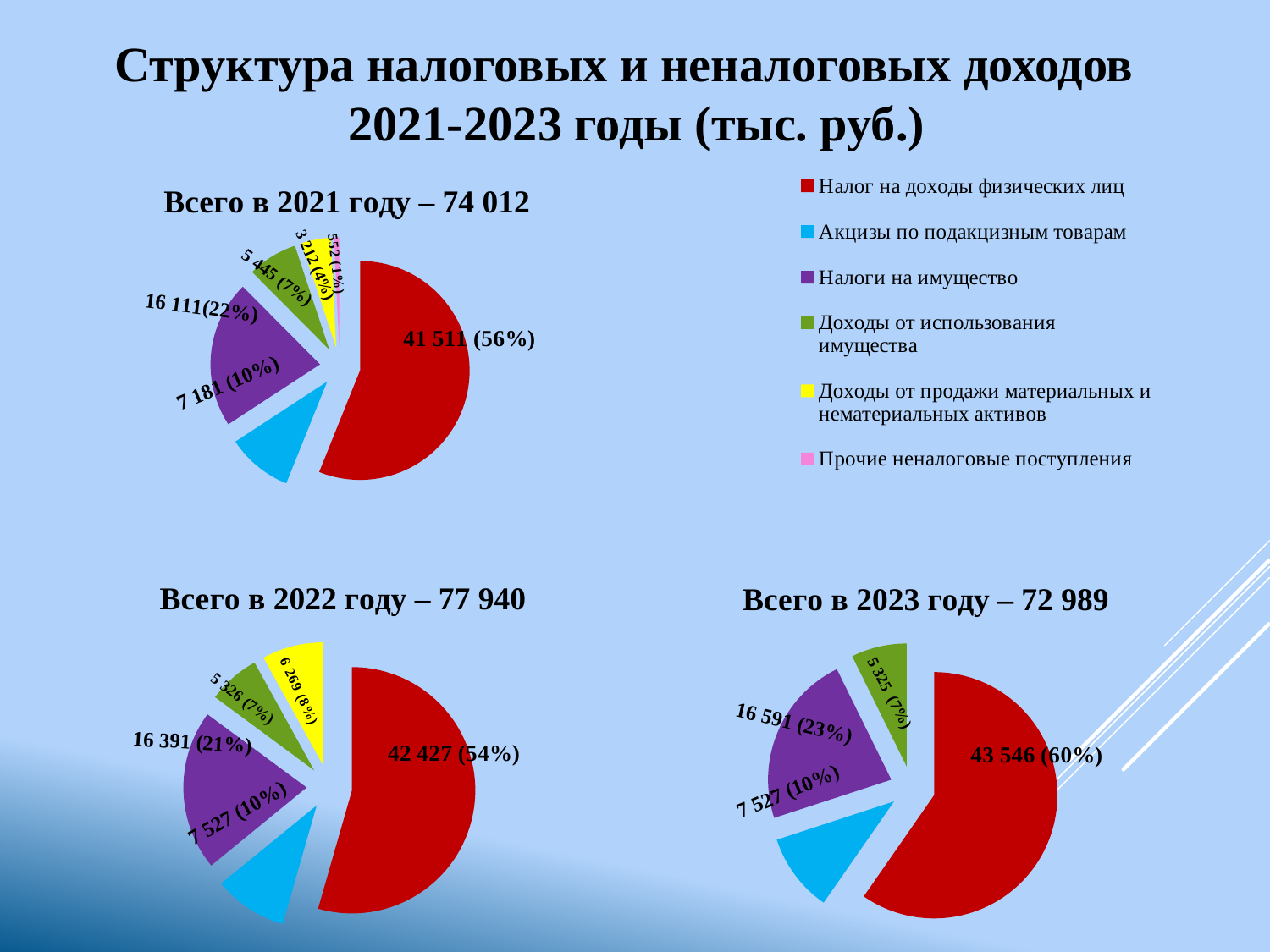
In the 2023 pie chart (Всего в 2023 году), what is the value for Налоги на имущество? 16 591 In the 2021 pie chart, what share of the total does Налоги на имущество represent? 22% In the 2021 pie chart, which category has the smallest slice? Прочие неналоговые поступления In the 2021 pie chart, what is the value for Прочие неналоговые поступления? 552 In the 2022 pie chart, what share does Налог на доходы физических лиц represent? 54% In the 2023 pie chart, which category has the largest slice? Налог на доходы физических лиц What is the difference between the Налог на доходы физических лиц value in the 2023 pie chart and in the 2022 pie chart? 1 119 How many series does the legend list? 6 What kind of charts are shown on the slide? Pie charts In the 2022 pie chart (Всего в 2022 году), what is the value for Доходы от продажи материальных и нематериальных активов? 6 269 In the 2021 pie chart (Всего в 2021 году), what is the value for Налог на доходы физических лиц? 41 511 In the 2022 pie chart, how many slices are there? 5